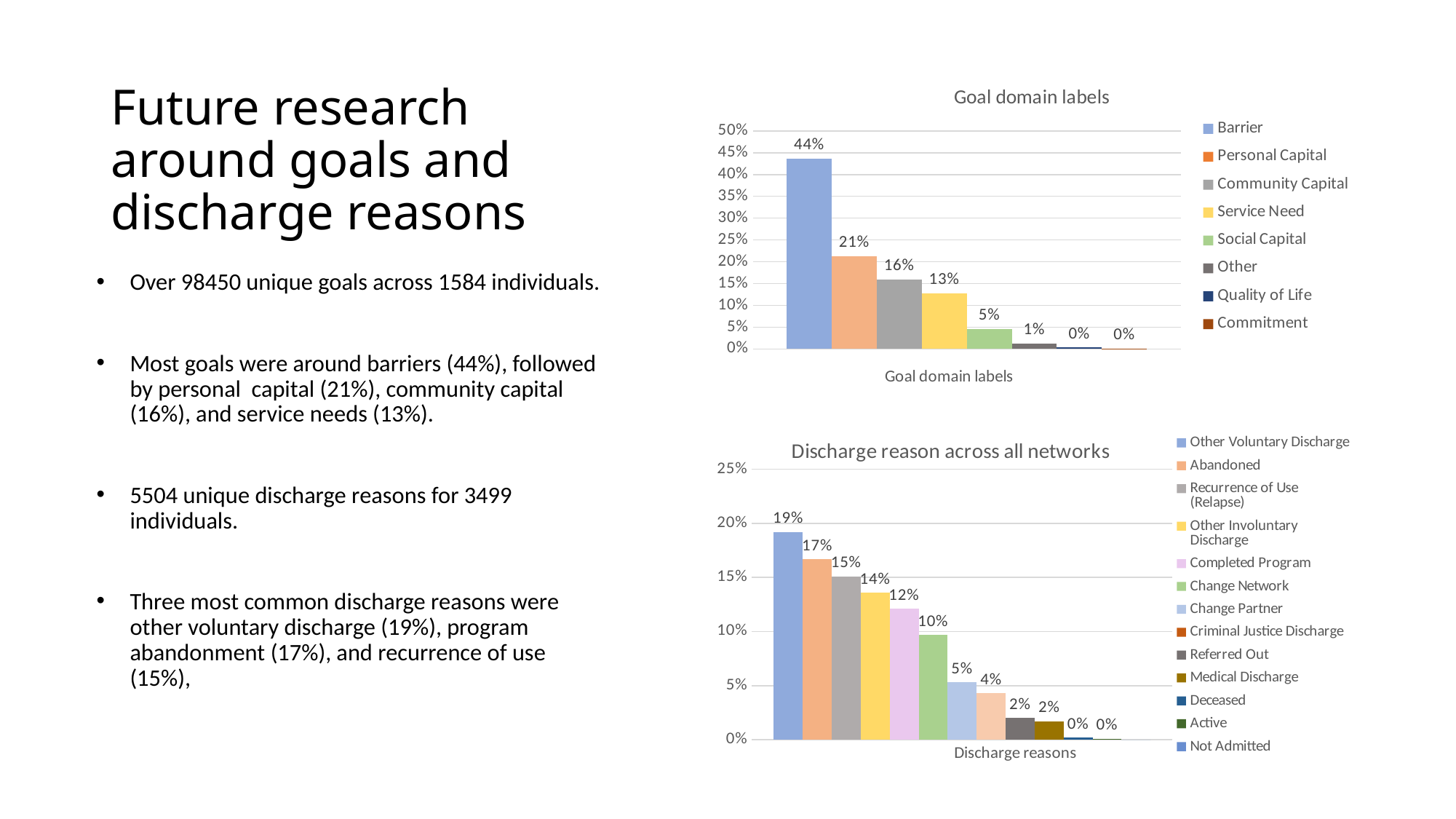
In the 'Goal domain labels' chart, what is the value for Barrier? 44% In the 'Discharge reason across all networks' chart, how many series does the legend list? 13 In the 'Goal domain labels' chart, which category has the highest value? Barrier In the 'Goal domain labels' chart, how many series does the legend list? 8 In the 'Goal domain labels' chart, which is larger, Social Capital or Other? Social Capital In the 'Discharge reason across all networks' chart, what is the value for Abandoned? 17% In the 'Discharge reason across all networks' chart, which category has the highest value? Other Voluntary Discharge In the 'Goal domain labels' chart, what is the value for Service Need? 13% What kind of chart is 'Discharge reason across all networks'? Bar chart In the 'Goal domain labels' chart, what is the difference between Personal Capital and Community Capital? 5% In the 'Discharge reason across all networks' chart, what is the value for Completed Program? 12% In the 'Discharge reason across all networks' chart, what is the difference between Other Voluntary Discharge and Change Network? 9%